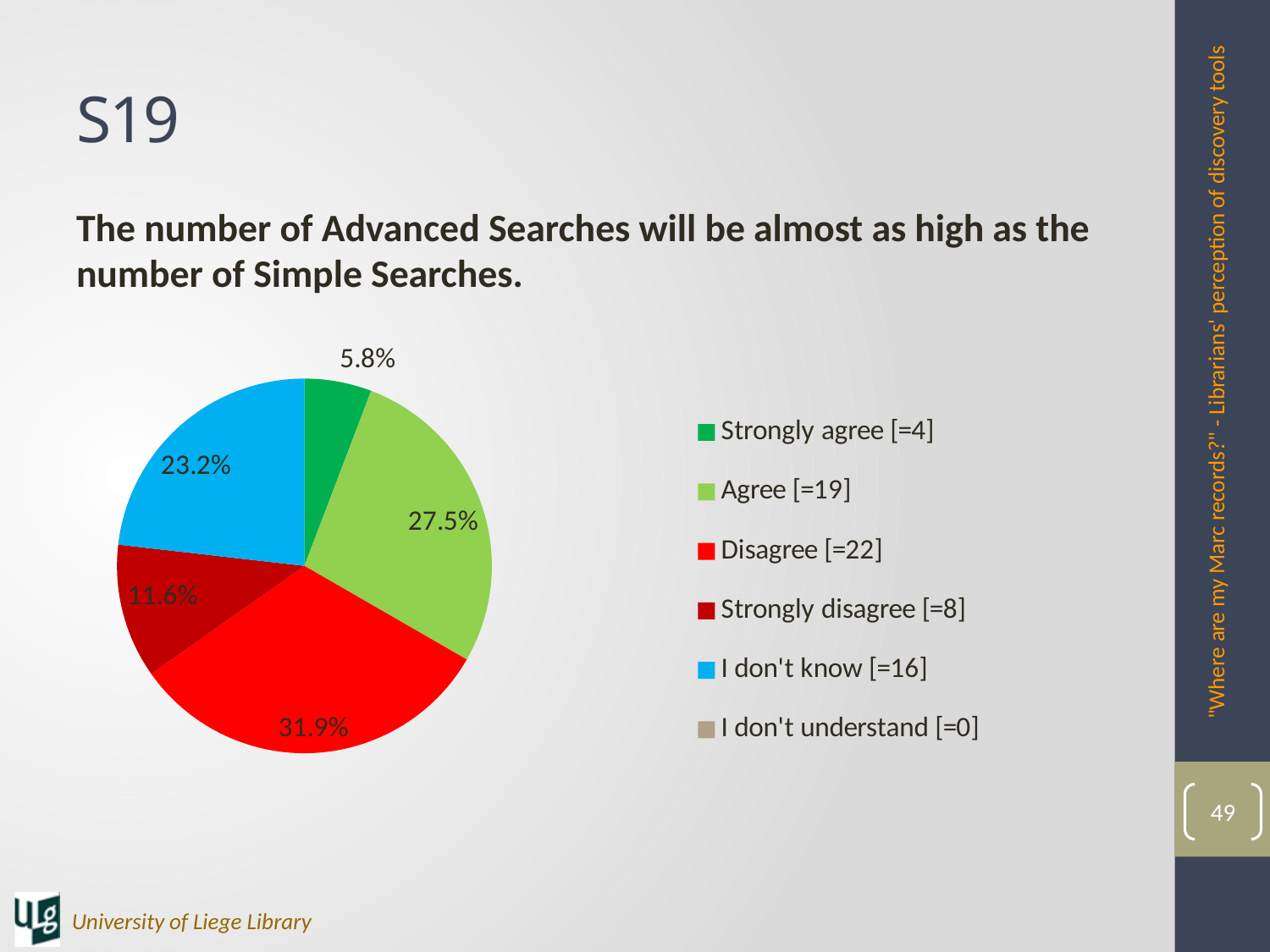
What percentage of the pie does the Strongly disagree slice represent? 11.6% What is the difference in percentage points between the Disagree slice and the Agree slice? 4.4 According to the legend, how many respondents answered Disagree? 22 What percentage of the pie does the Strongly agree slice represent? 5.8% Which response category with a visible slice has the smallest share of the pie? Strongly agree Which response category has the largest share of the pie? Disagree Which slice is larger, I don't know or Strongly disagree? I don't know What type of chart is shown on the slide? pie chart What percentage of the pie does the Agree slice represent? 27.5% How many entries does the legend list? 6 What percentage of the pie does the I don't know slice represent? 23.2% What percentage of the pie does the Disagree slice represent? 31.9%